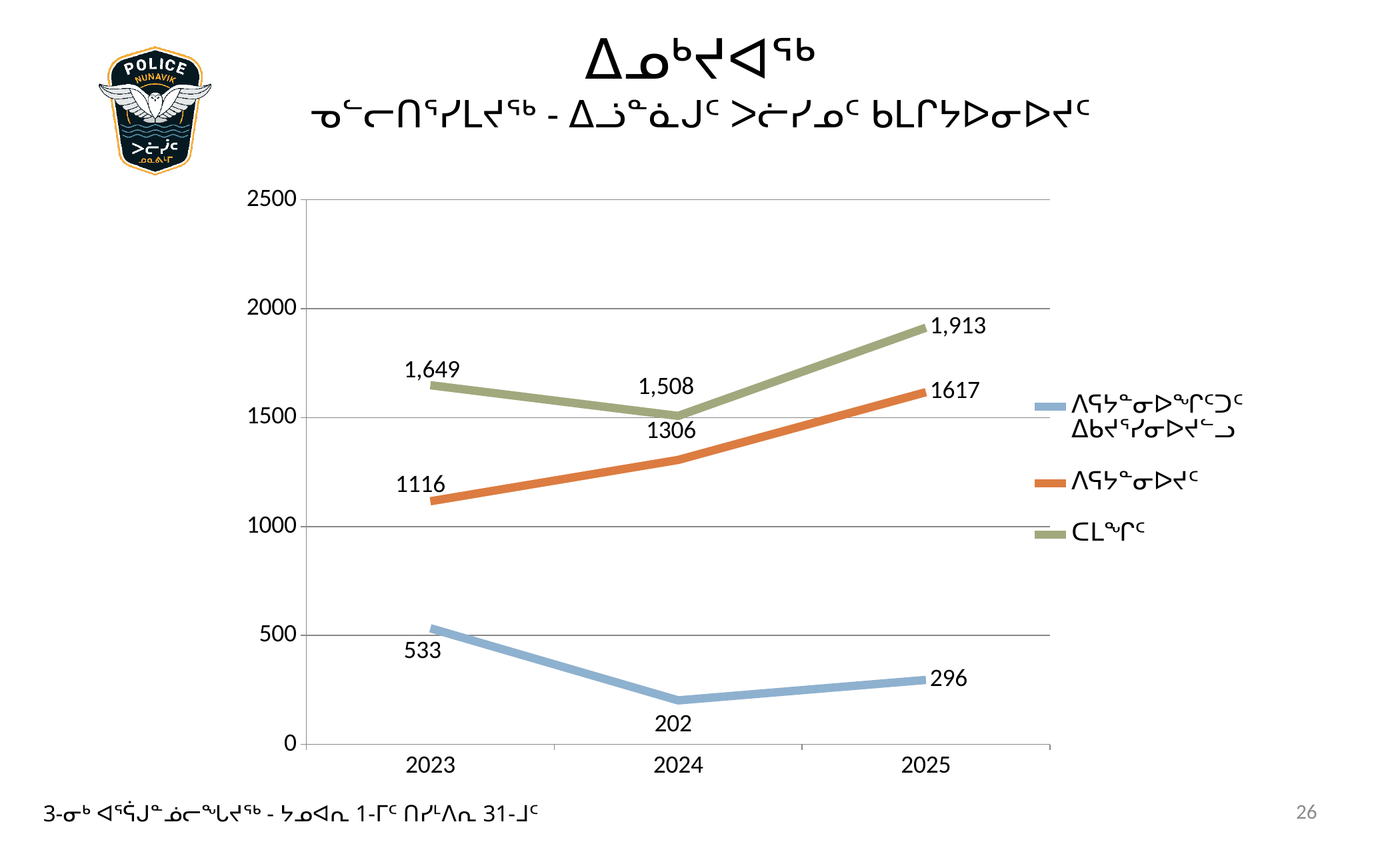
In which year is the blue line at its lowest? 2024 What is the value of the green line in 2024? 1,508 In which year is the orange line at its highest? 2025 What is the difference between the orange line's values in 2025 and 2023? 501 What is the value of the green line in 2025? 1,913 How many years are shown on the x axis? 3 Which is larger in 2024, the green line or the orange line? the green line What is the value of the orange line in 2023? 1116 Does the orange line rise or fall from 2023 to 2025? rise What is the value of the blue line in 2024? 202 How many series does the legend list? 3 What kind of chart is shown on the slide? line chart